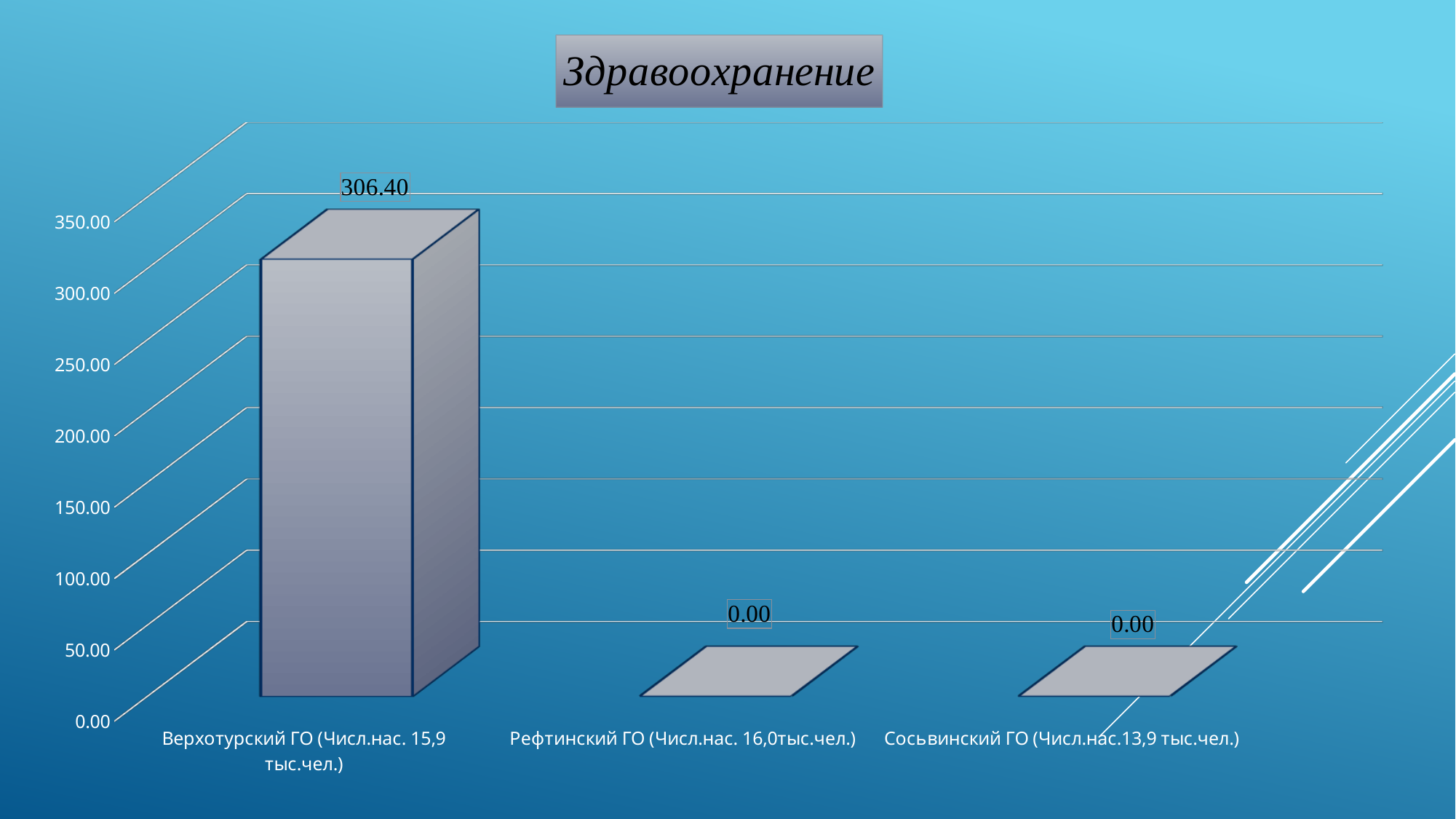
What is the value for Сосьвинский ГО? 0.00 What is the difference between the values for Верхотурский ГО and Рефтинский ГО? 306.40 What is the title of the slide? Здравоохранение Is the value for Верхотурский ГО greater or less than 300.00? greater What is the highest value shown on the vertical axis? 350.00 How many categories have a value of 0.00? 2 What kind of chart is shown on the slide? bar chart Which category has the highest value? Верхотурский ГО How many categories are shown on the chart? 3 What is the value for Верхотурский ГО? 306.40 What is the value for Рефтинский ГО? 0.00 Which is larger, the value for Верхотурский ГО or the value for Сосьвинский ГО? Верхотурский ГО